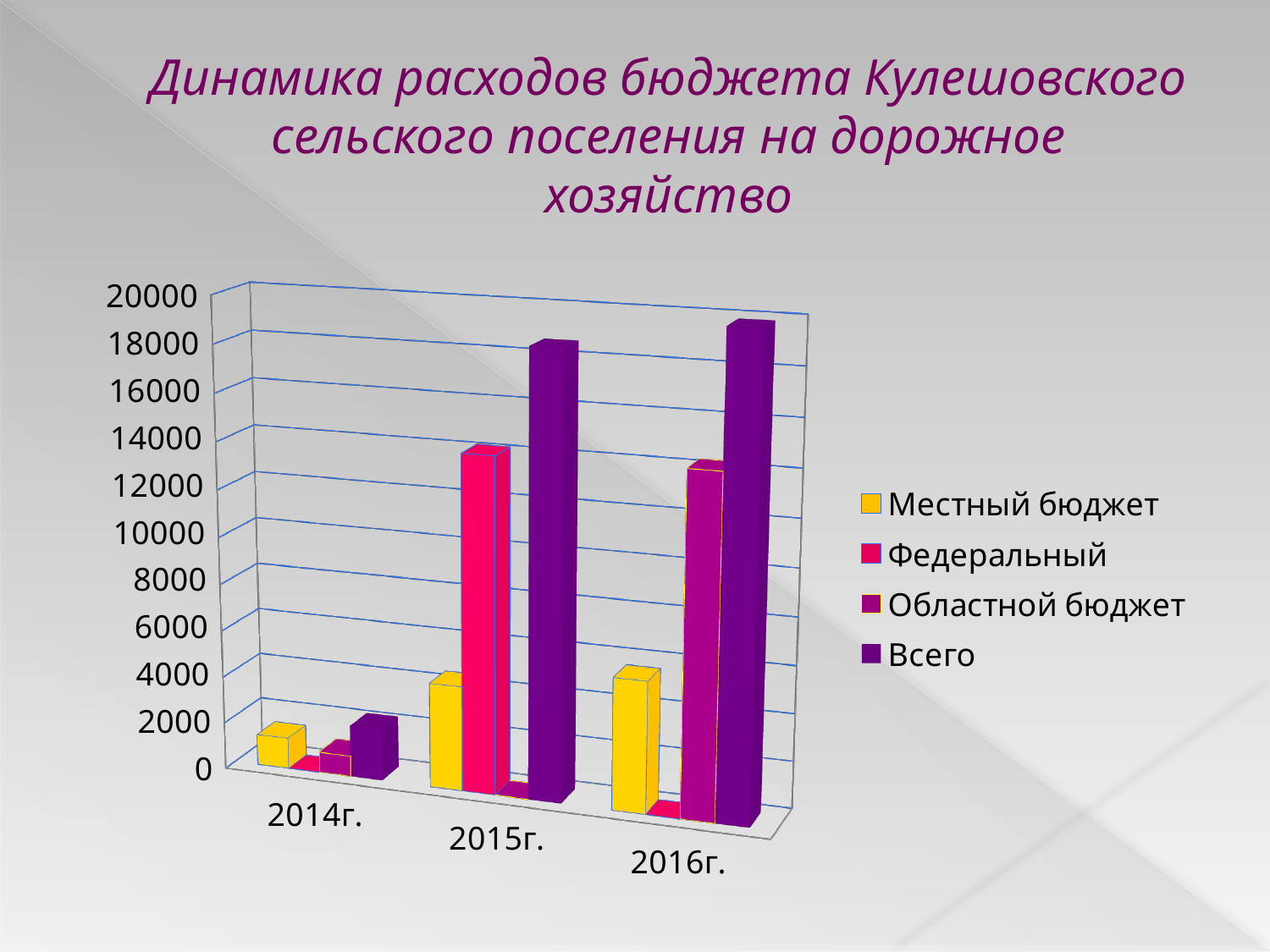
How many years are shown on the x axis of the chart? 3 Which is larger: Местный бюджет in 2014г. or Местный бюджет in 2016г.? Местный бюджет in 2016г. Which year has the lowest value for Всего? 2014г. Which year has the highest value for Всего? 2016г. Is the value for Всего in 2015г. greater or less than 16000? greater Does the value for Всего rise or fall from 2014г. to 2016г.? rise Is the value for Областной бюджет in 2016г. greater or less than 10000? greater Is the value for Федеральный in 2015г. greater or less than 10000? greater How many series does the chart legend list? 4 Which legend entry is shown in yellow? Местный бюджет What kind of chart is shown on the slide? bar chart